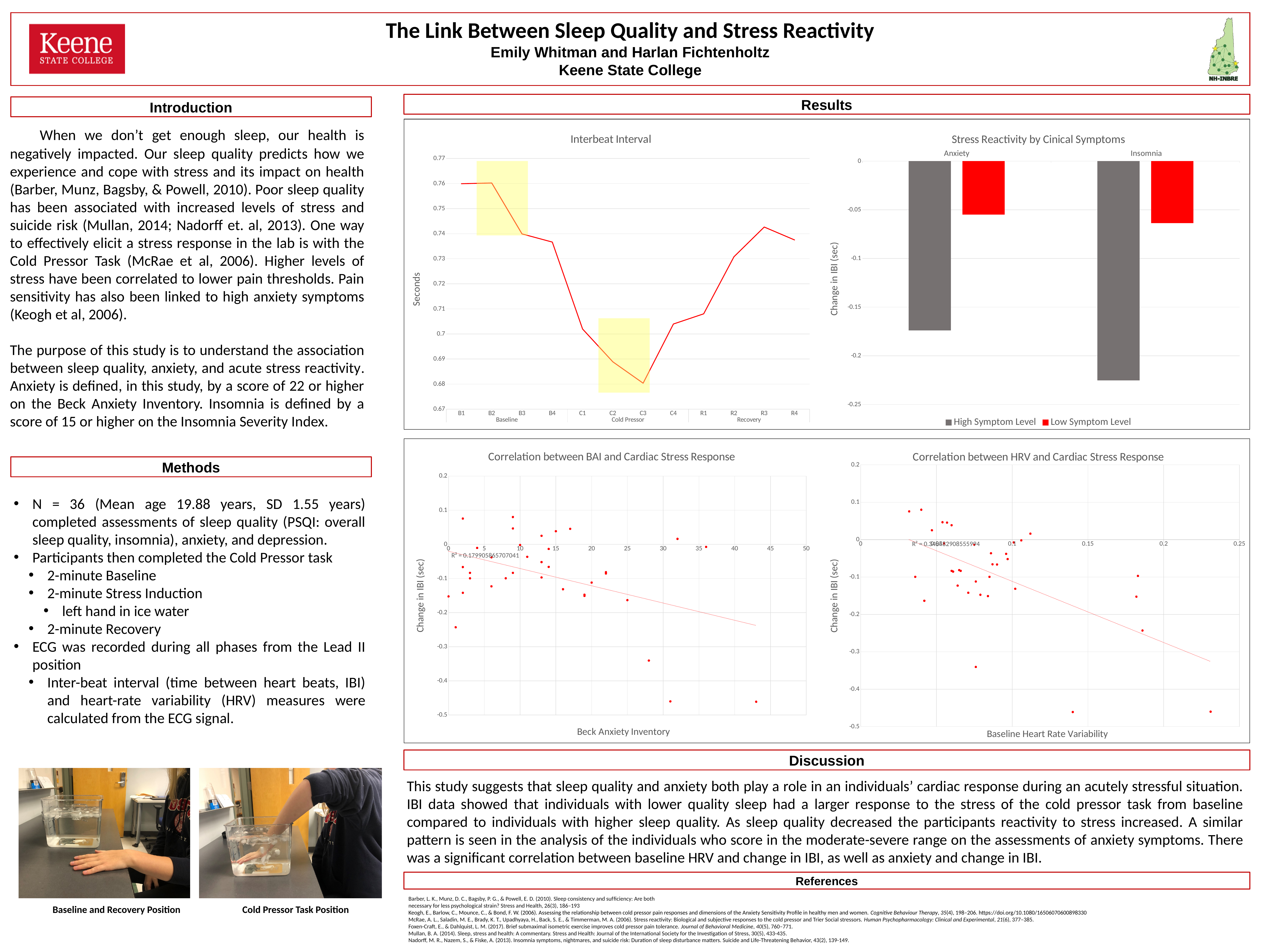
In the Interbeat Interval chart, is the value for C3 greater or less than 0.69? less In the Stress Reactivity by Cinical Symptoms chart, which category has the lower (more negative) High Symptom Level bar, Anxiety or Insomnia? Insomnia What kind of chart is the Correlation between BAI and Cardiac Stress Response chart? scatter chart In the Interbeat Interval chart, how many points are labelled along the x axis? 12 What kind of chart is the Interbeat Interval chart? line chart In the Interbeat Interval chart, do the values rise or fall from B2 to C3? fall What is the x-axis label of the Correlation between BAI and Cardiac Stress Response chart? Beck Anxiety Inventory What kind of chart is the Stress Reactivity by Cinical Symptoms chart? bar chart In the Stress Reactivity by Cinical Symptoms chart, is the High Symptom Level value for Insomnia greater or less than -0.2? less In the Interbeat Interval chart, which x-axis point has the lowest value? C3 In the Stress Reactivity by Cinical Symptoms chart, how many series does the legend list? 2 In the Stress Reactivity by Cinical Symptoms chart, is the Low Symptom Level value for Anxiety greater or less than -0.1? greater